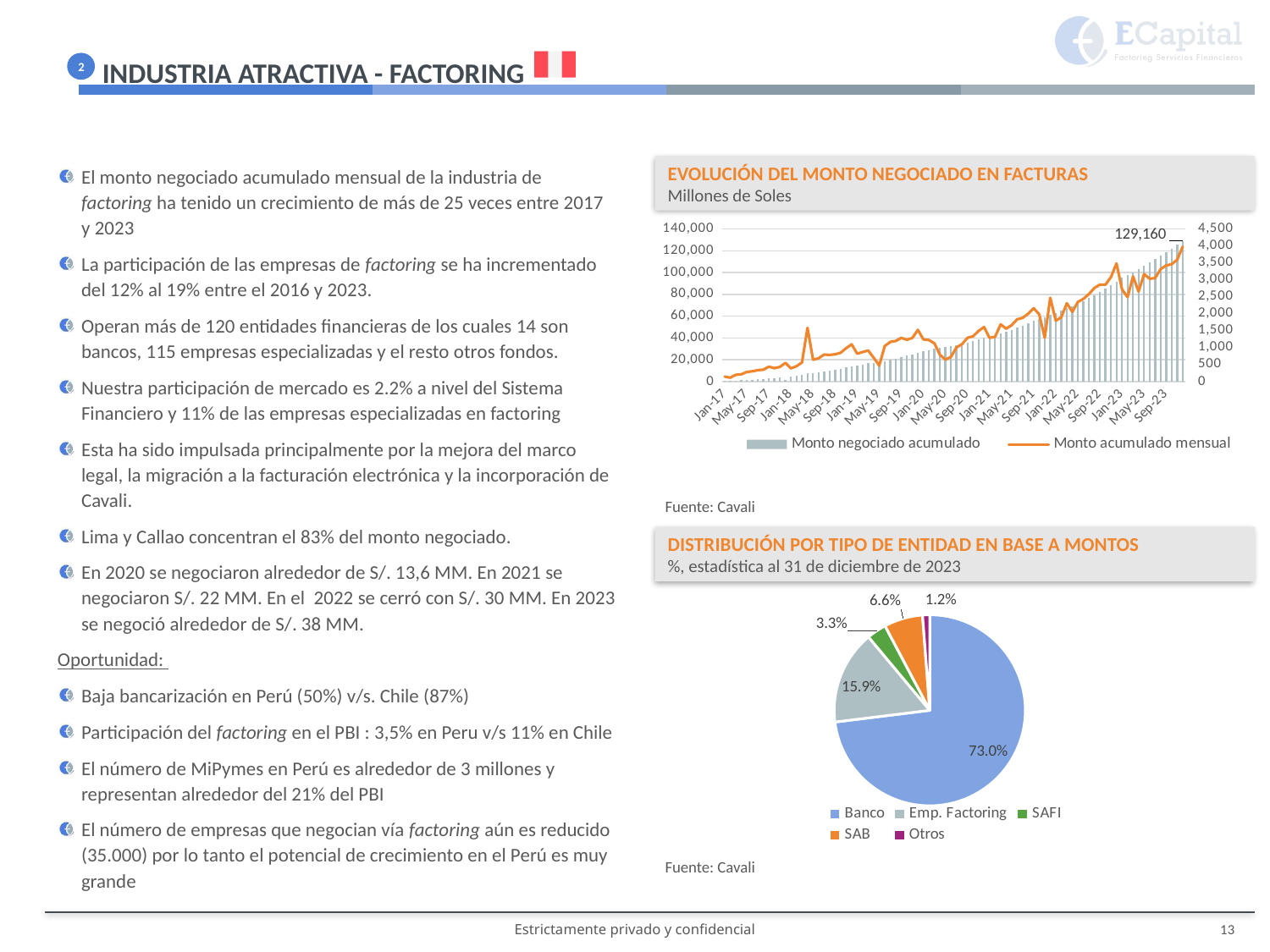
In the pie chart 'Distribución por tipo de entidad en base a montos', which entity type has the largest share? Banco What unit is stated in the subtitle of the chart 'Evolución del monto negociado en facturas'? Millones de Soles In the pie chart 'Distribución por tipo de entidad en base a montos', which entity type has the smallest share? Otros In the chart 'Evolución del monto negociado en facturas', what is the labelled value of the last bar of Monto negociado acumulado? 129,160 How many entity types does the legend of the pie chart 'Distribución por tipo de entidad en base a montos' list? 5 In the pie chart 'Distribución por tipo de entidad en base a montos', what share does Banco have? 73.0% In the pie chart 'Distribución por tipo de entidad en base a montos', what share does SAB have? 6.6% In the pie chart 'Distribución por tipo de entidad en base a montos', what share does Emp. Factoring have? 15.9% How many series does the legend of the chart 'Evolución del monto negociado en facturas' list? 2 In the pie chart 'Distribución por tipo de entidad en base a montos', which has a larger share, SAFI or SAB? SAB In the pie chart 'Distribución por tipo de entidad en base a montos', what is the difference between the shares of Emp. Factoring and SAB? 9.3% In the chart 'Evolución del monto negociado en facturas', does the Monto negociado acumulado series rise or fall from Jan-17 to Sep-23? rise